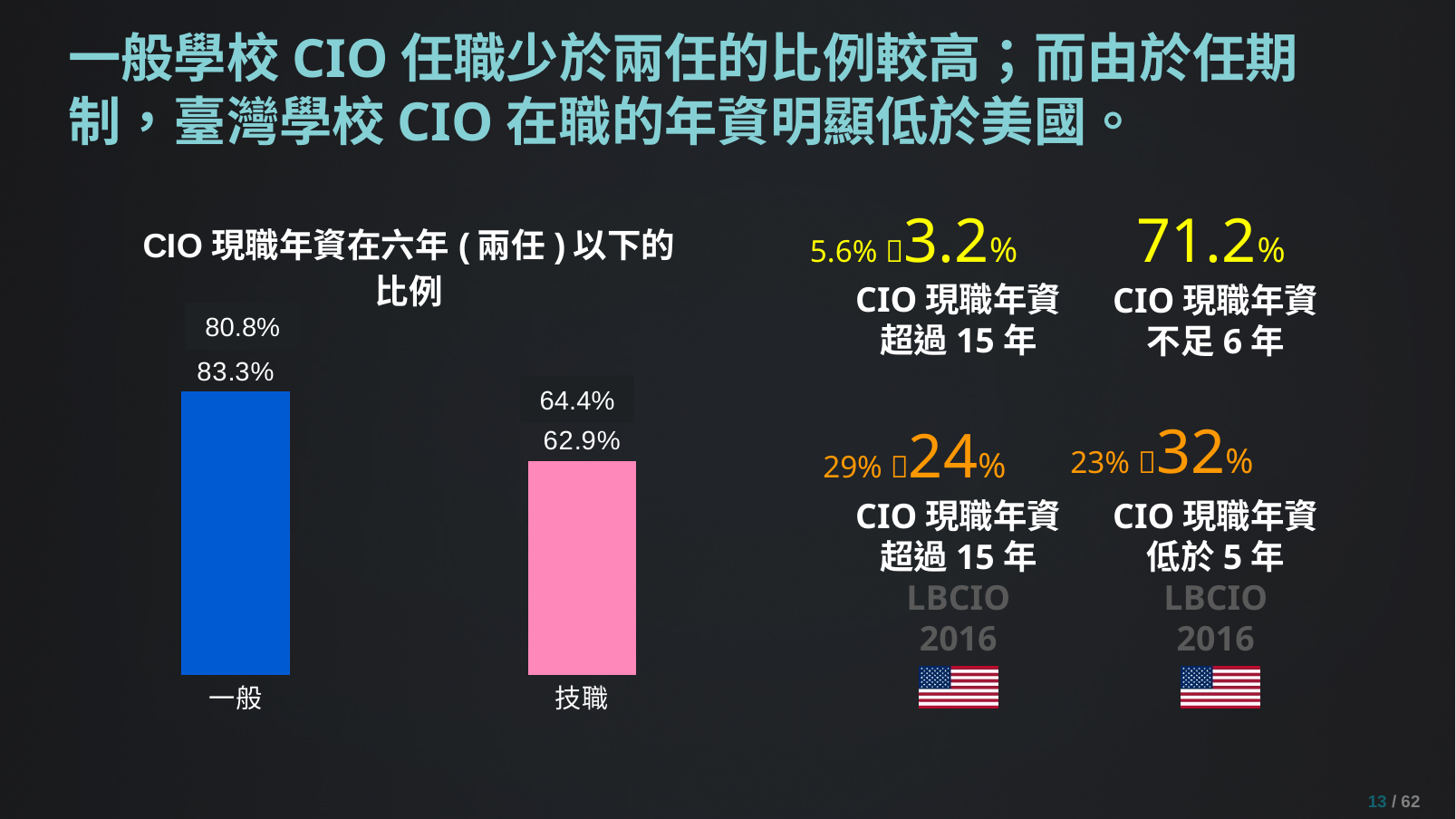
Which category has the taller bar in the chart, 一般 or 技職? 一般 What colour is the bar for 技職? pink What is the difference between the values printed immediately above the bar tops for 一般 (83.3%) and 技職 (62.9%)? 20.4% How many categories does the bar chart show? 2 What is the title of the bar chart on the left? CIO 現職年資在六年 ( 兩任 ) 以下的比例 Which category has the highest bar in the chart? 一般 What kind of chart is shown on the left of the slide? bar chart What is the upper of the two values printed above the 一般 bar? 80.8% What is the upper of the two values printed above the 技職 bar? 64.4% What value is printed immediately above the top of the pink bar for 技職? 62.9% What value is printed immediately above the top of the blue bar for 一般? 83.3% Which category has the lowest bar in the chart? 技職